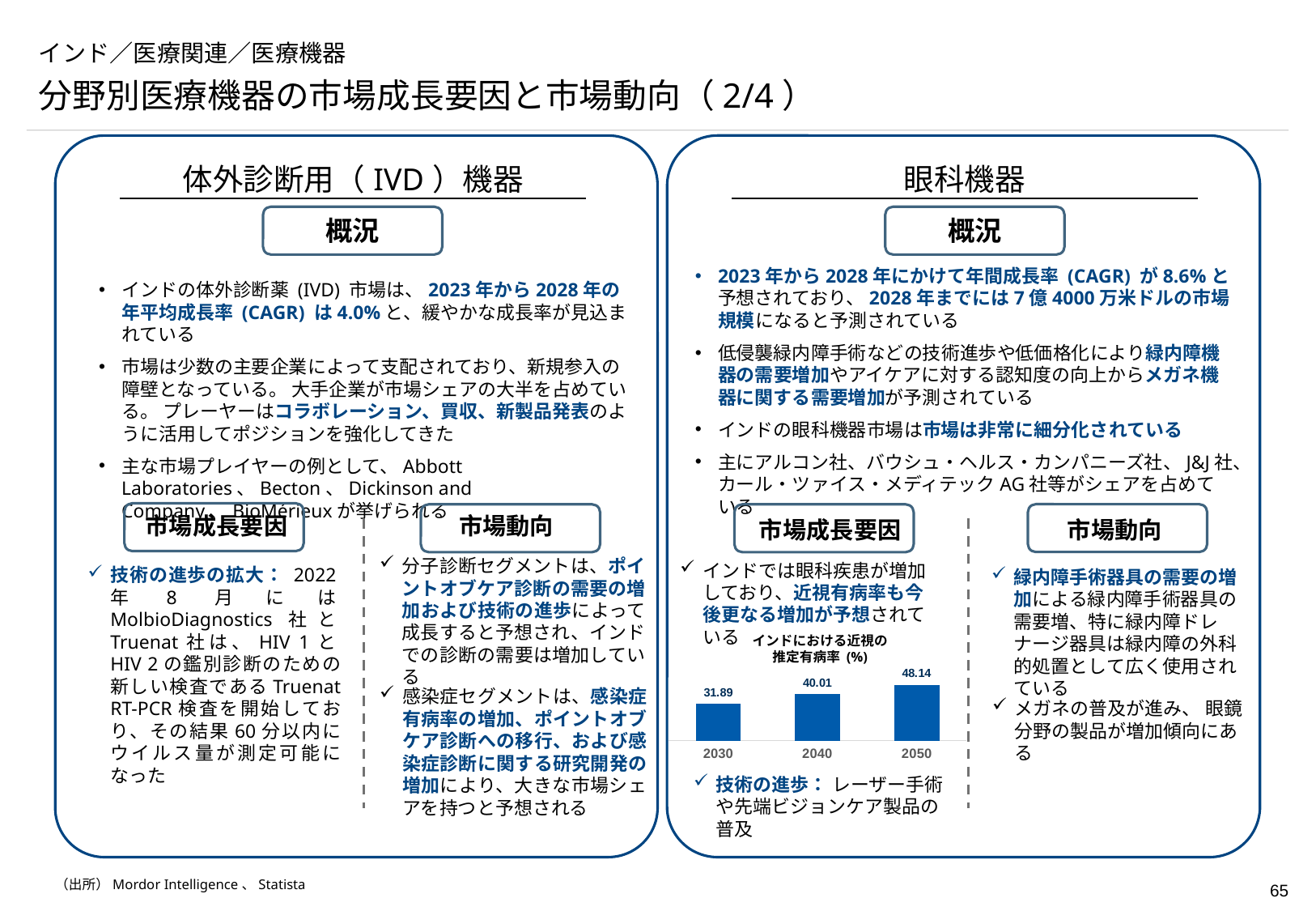
Which year has the lowest value in the chart? 2030 What is the title of the chart on the slide? インドにおける近視の推定有病率 (%) What is the estimated myopia prevalence in India for 2030 according to the chart? 31.89 How many years (bars) are shown in the chart? 3 What is the difference between the values for 2050 and 2030? 16.25 What type of chart is used to show the estimated myopia prevalence in India? Bar chart Do the values in the chart rise or fall from 2030 to 2050? Rise Which year has the highest value in the chart? 2050 What value does the chart show for 2050? 48.14 What is the difference between the values for 2040 and 2030? 8.12 What value does the chart show for 2040? 40.01 Which is larger, the value for 2040 or the value for 2050? 2050